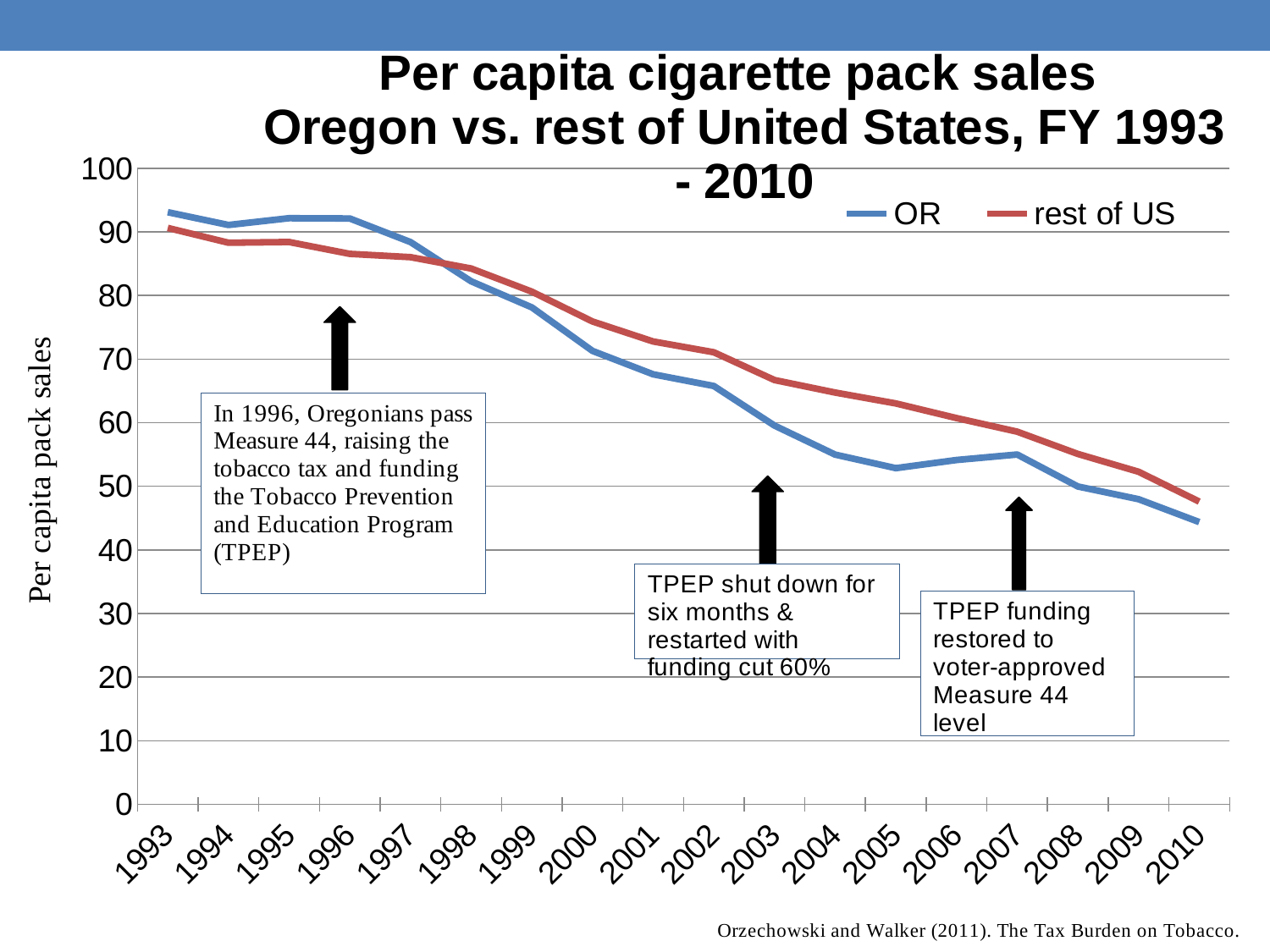
In 2005, which series has the larger value, OR or rest of US? rest of US Is the value for OR in 1996 greater or less than 90? greater In which year is the value for rest of US lowest? 2010 How many series does the legend list? 2 How many years are plotted along the x axis? 18 Is the value for OR in 2010 greater or less than 50? less What is the label on the y axis? Per capita pack sales Is the value for OR in 2001 greater or less than 70? less Do the per capita pack sales for OR rise or fall from 1993 to 2010? fall What kind of chart is shown on the slide? line chart In 1993, which series has the larger value, OR or rest of US? OR